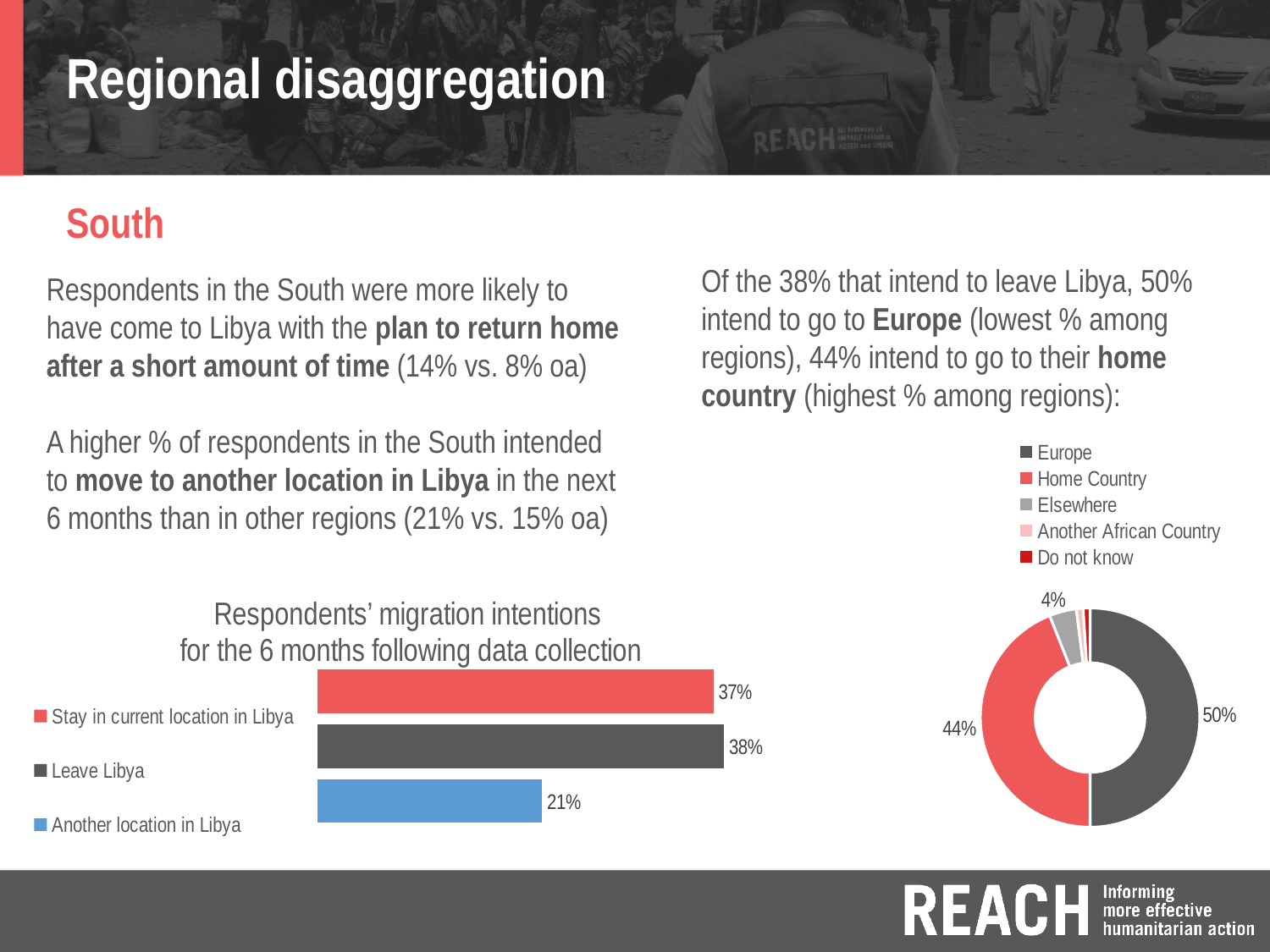
In the bar chart 'Respondents' migration intentions for the 6 months following data collection', which intention has the highest percentage? Leave Libya How many entries does the legend of the donut chart on the right of the slide list? 5 In the bar chart 'Respondents' migration intentions for the 6 months following data collection', what percentage of respondents intend to stay in their current location in Libya? 37% In the bar chart 'Respondents' migration intentions for the 6 months following data collection', which intention has the lowest percentage? Another location in Libya In the bar chart 'Respondents' migration intentions for the 6 months following data collection', what percentage of respondents intend to leave Libya? 38% In the donut chart on the right of the slide, what share of respondents intend to go to Europe? 50% What type of chart is the chart at the bottom left of the slide? Bar chart In the donut chart on the right of the slide, what share of respondents intend to go to their home country? 44% In the bar chart 'Respondents' migration intentions for the 6 months following data collection', what is the difference between the percentage for 'Leave Libya' and the percentage for 'Another location in Libya'? 17% In the bar chart 'Respondents' migration intentions for the 6 months following data collection', which is larger: 'Stay in current location in Libya' or 'Another location in Libya'? Stay in current location in Libya How many categories does the bar chart 'Respondents' migration intentions for the 6 months following data collection' show? 3 In the bar chart 'Respondents' migration intentions for the 6 months following data collection', what percentage of respondents intend to move to another location in Libya? 21%